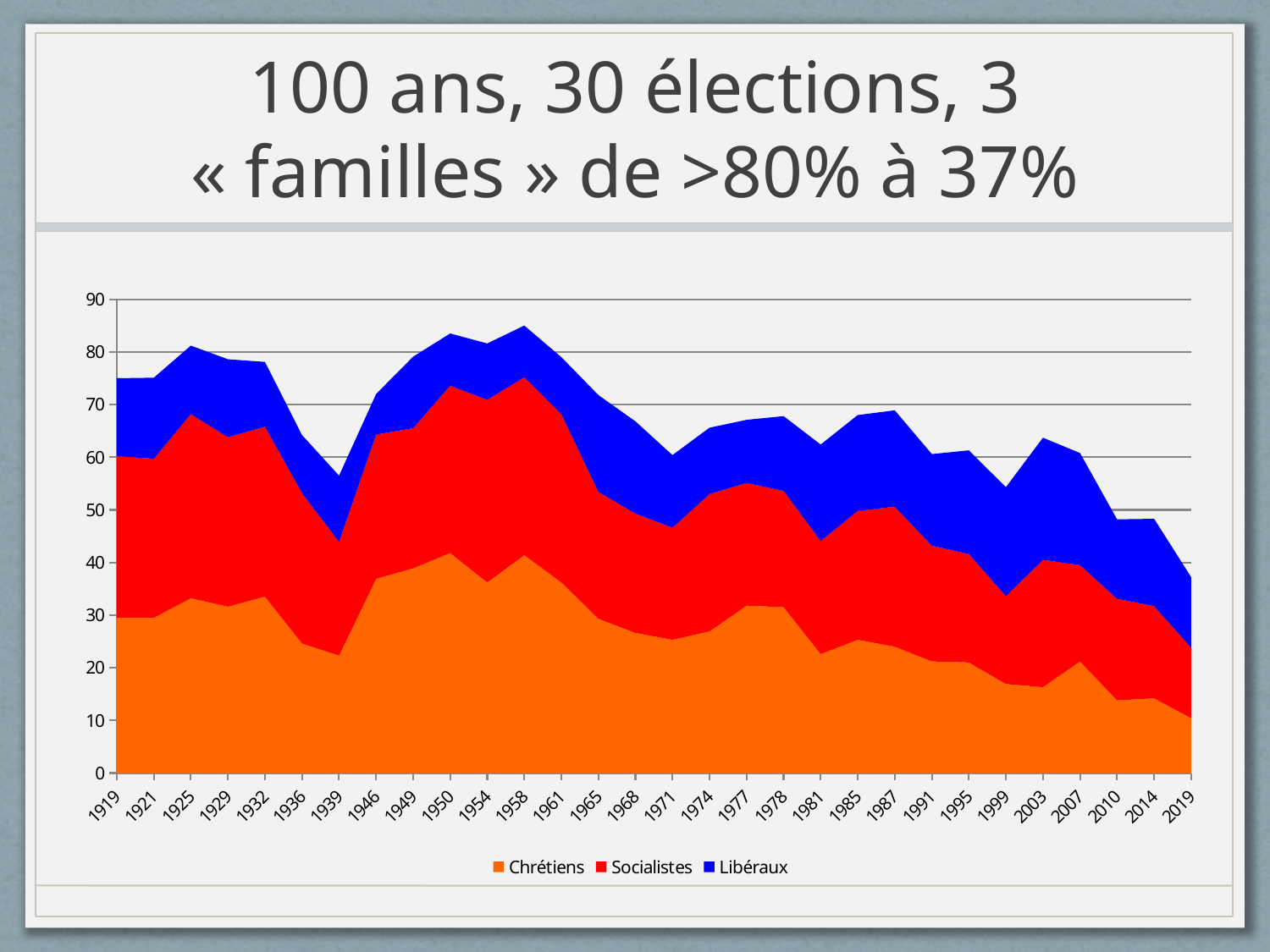
Which series are listed in the legend? Chrétiens, Socialistes, Libéraux Is the value for Chrétiens in 1950 greater or less than 30? greater How many series does the legend list? 3 Is the value for Chrétiens in 2019 greater or less than 20? less What kind of chart is shown on the slide? stacked area chart How many election years are plotted along the x axis? 30 In which year is the combined total of the three families lowest? 2019 Is the combined total of the three families in 2019 greater or less than 40? less Is the value for Chrétiens larger in 1919 or in 2019? 1919 What is the first year shown on the x axis? 1919 Over the whole period from 1919 to 2019, does the combined total of the three families generally rise or fall? fall